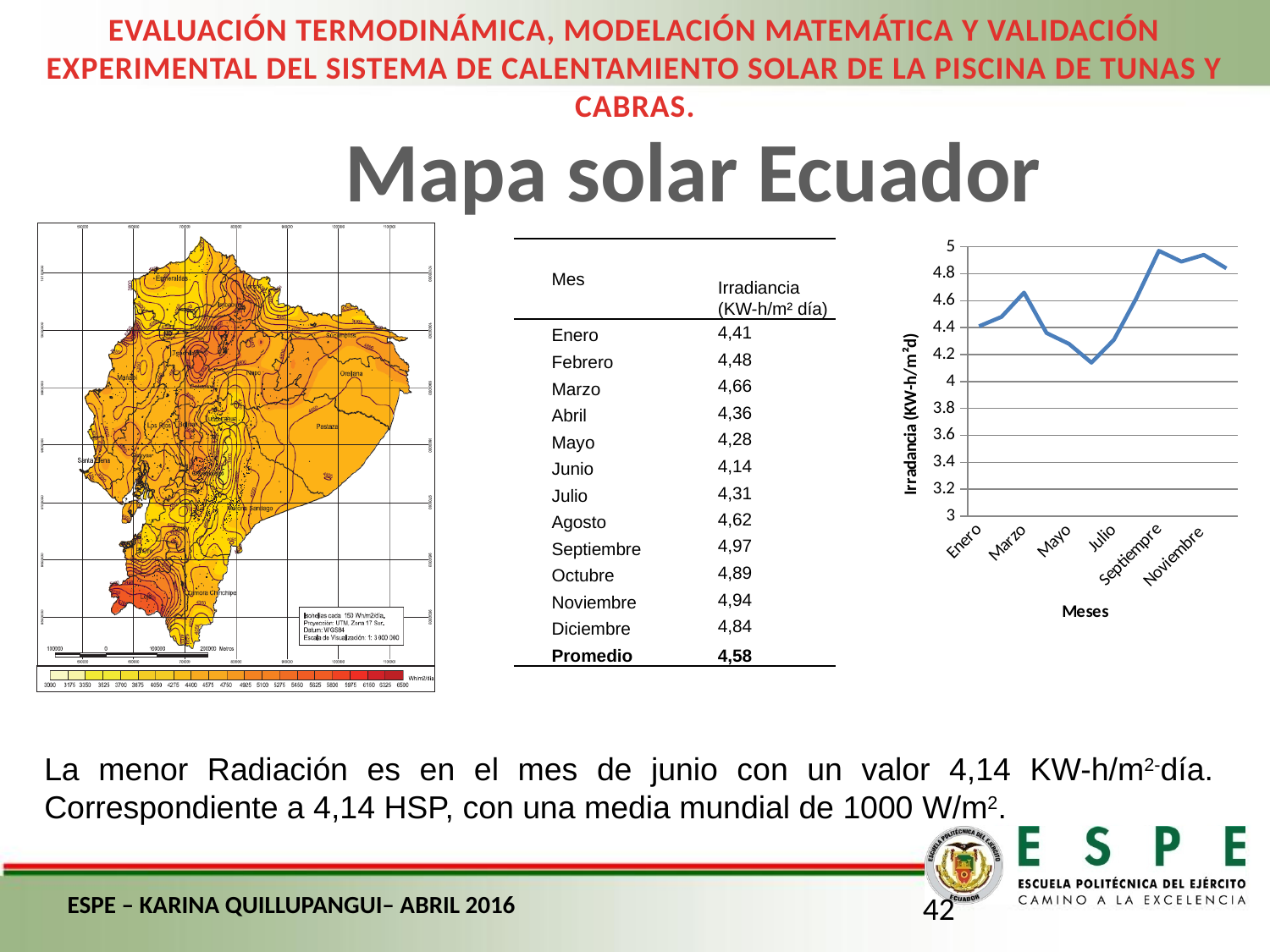
What is the irradiance value for Septiembre? 4,97 What is the irradiance value for Junio? 4,14 Does the line rise or fall from Junio to Septiembre? rises How many monthly data points are plotted in the line chart? 12 In the line chart, which month has the highest irradiance? Septiembre What is the title of the horizontal axis of the line chart? Meses Is the value for Mayo greater or less than 4.4? less Is the value for Agosto greater or less than 4.4? greater In the line chart, which month has the lowest irradiance? Junio What is the difference between the irradiance for Septiembre and Junio? 0,83 Which month has the larger irradiance, Marzo or Abril? Marzo What kind of chart is shown on the right of the slide? line chart